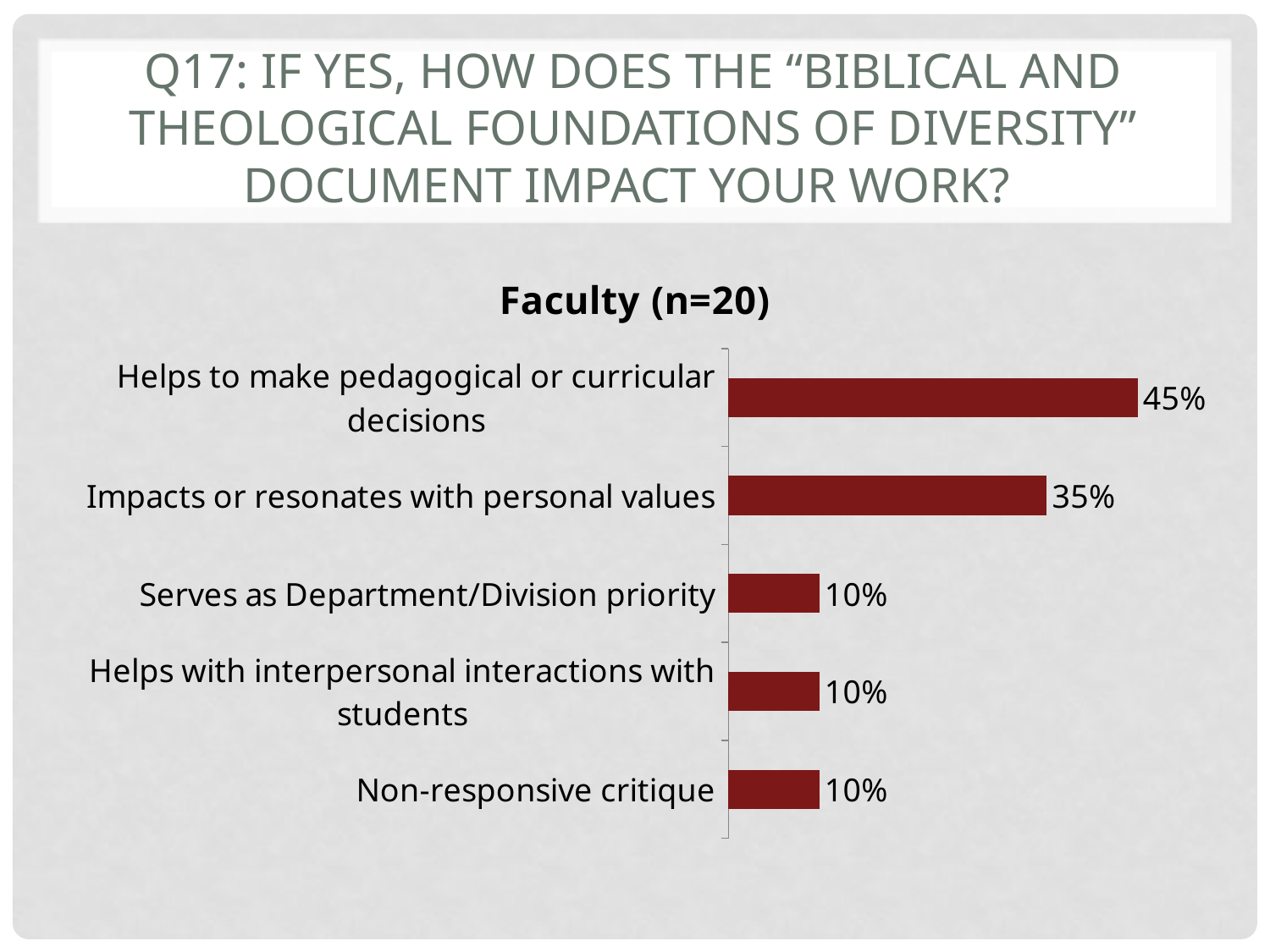
What kind of chart is shown on the slide? Bar chart What percentage of faculty said the document helps to make pedagogical or curricular decisions? 45% What is the value for "Impacts or resonates with personal values"? 35% How many categories share the lowest value of 10%? 3 Which category has the highest value? Helps to make pedagogical or curricular decisions Which is larger: "Impacts or resonates with personal values" or "Helps with interpersonal interactions with students"? Impacts or resonates with personal values What is the difference between "Impacts or resonates with personal values" and "Serves as Department/Division priority"? 25% How many categories are shown in the chart? 5 What percentage is shown for "Serves as Department/Division priority"? 10% What is the title of the chart? Faculty (n=20) What is the value for "Non-responsive critique"? 10% What is the difference between "Helps to make pedagogical or curricular decisions" and "Impacts or resonates with personal values"? 10%